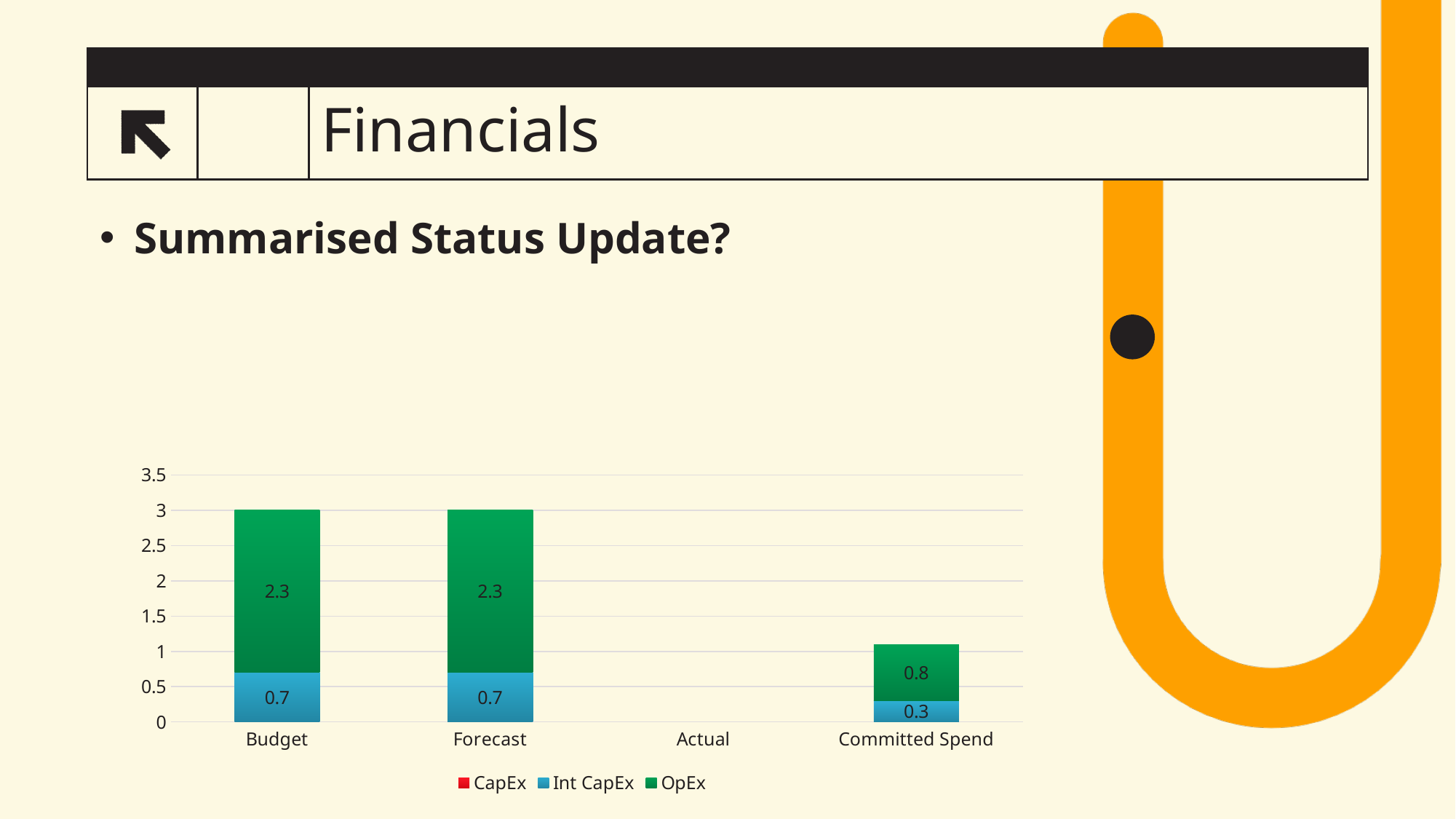
Which series is shown in green in the legend? OpEx What is the difference between the OpEx value for Budget and the OpEx value for Committed Spend? 1.5 What is the Int CapEx value for Forecast? 0.7 What kind of chart is shown on the slide? Stacked bar chart What is the OpEx value for Committed Spend? 0.8 How many categories are shown on the x axis? 4 How many series does the legend list? 3 What is the total of the stacked bar for Committed Spend? 1.1 Which is larger, the Int CapEx value for Budget or the Int CapEx value for Committed Spend? Budget What is the total of the stacked bar for Budget? 3 What is the Int CapEx value for Committed Spend? 0.3 What is the OpEx value for Budget? 2.3